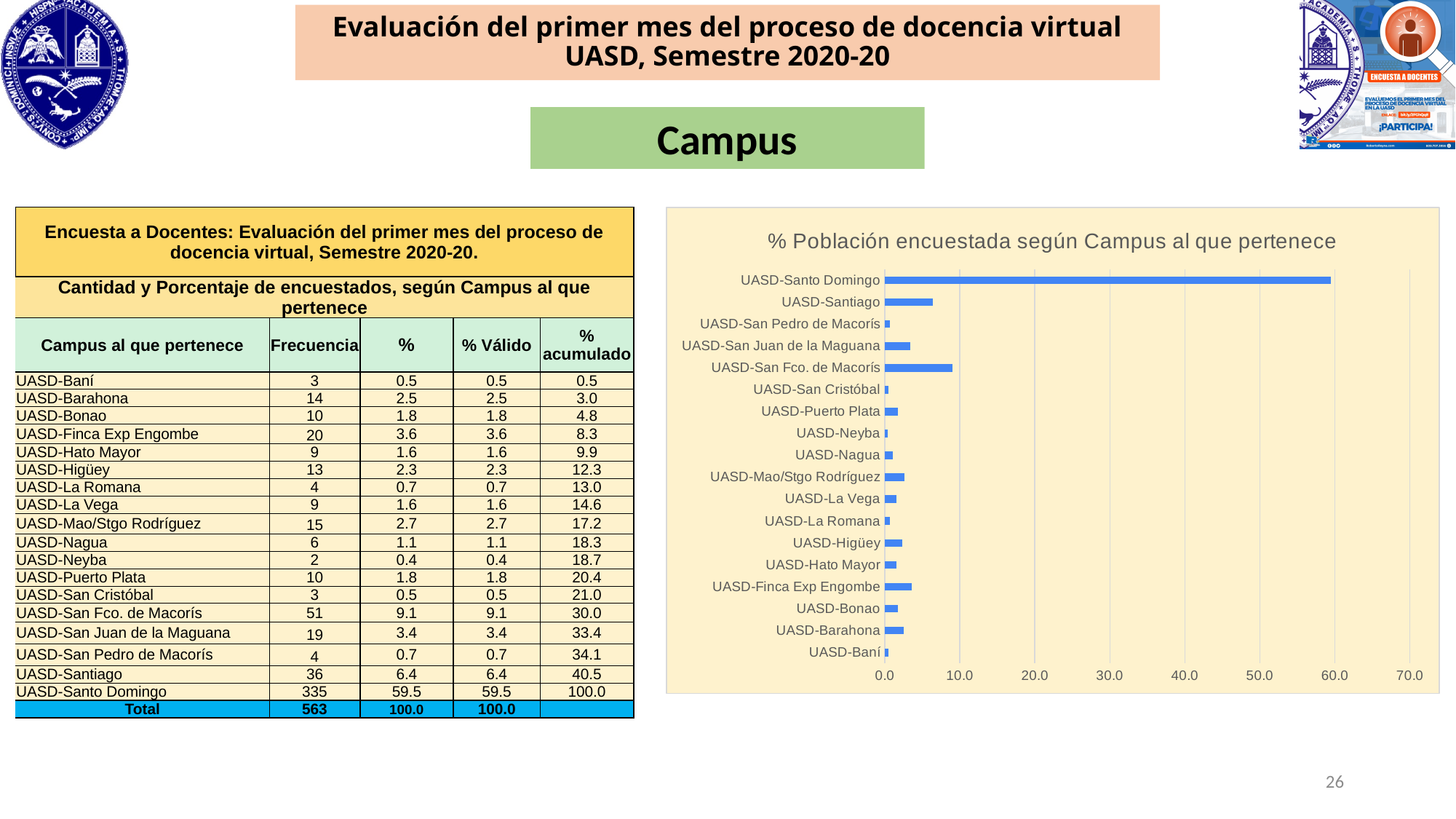
Which campus has the highest value in the chart? UASD-Santo Domingo What is the highest value shown on the chart's horizontal axis? 70.0 According to the slide, what percentage of respondents belong to UASD-Santo Domingo? 59.5 What kind of chart is shown on the slide? bar chart Is the value for UASD-Santiago greater or less than 10.0? less Which is larger in the chart, the value for UASD-Santiago or for UASD-Finca Exp Engombe? UASD-Santiago How many campuses are plotted in the chart? 18 What is the title of the chart? % Población encuestada según Campus al que pertenece Which is larger in the chart, the value for UASD-Santiago or for UASD-San Fco. de Macorís? UASD-San Fco. de Macorís Is the value for UASD-San Fco. de Macorís greater or less than 20.0? less Is the value for UASD-Santo Domingo greater or less than 50.0? greater According to the slide, what percentage of respondents belong to UASD-Santiago? 6.4